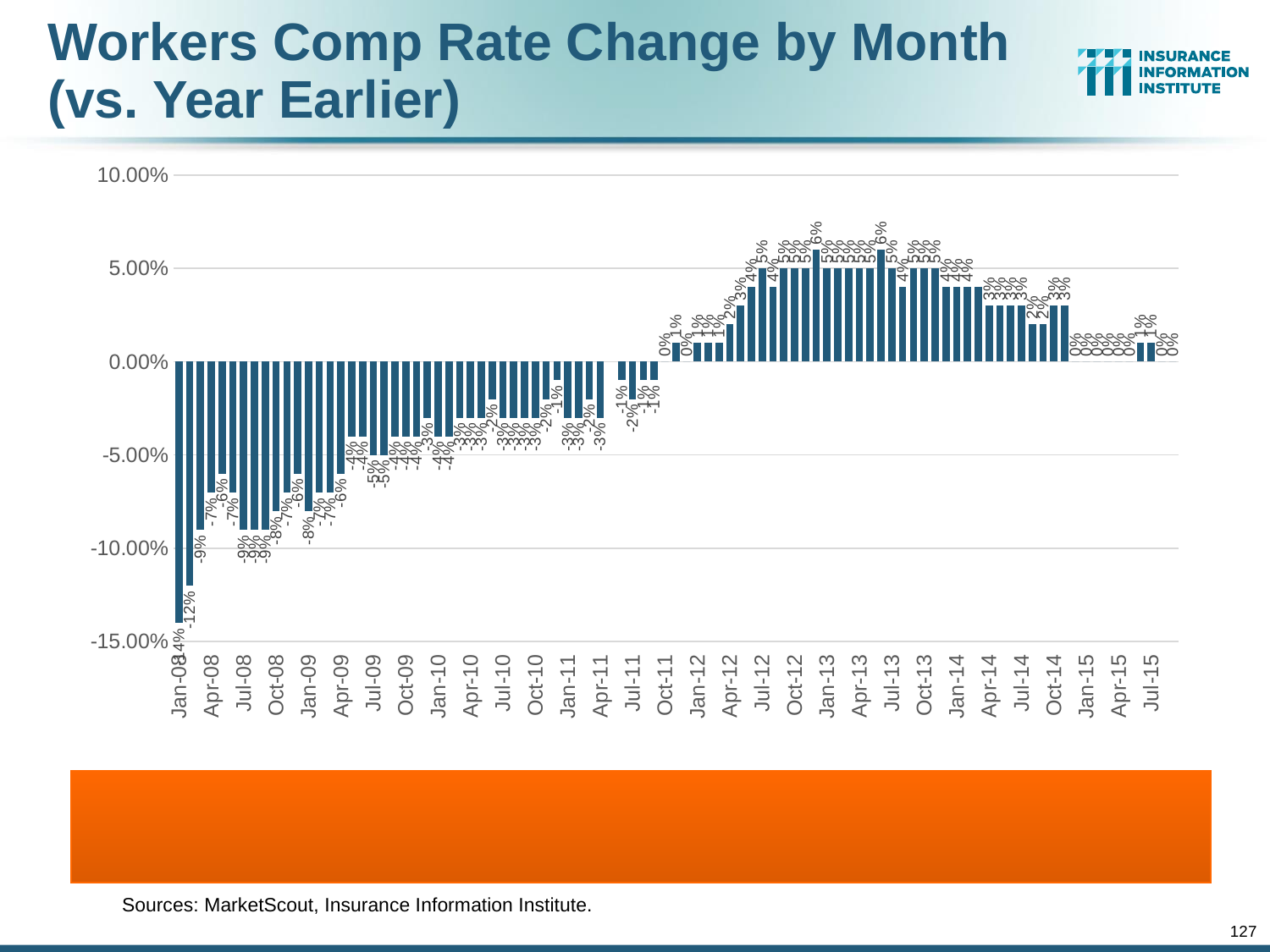
Is the value for Jul-08 greater or less than -5.00%? less Do the values generally rise or fall from Jan-08 to Jan-13? rise Is the value for Jan-13 greater or less than 0.00%? greater What is the workers comp rate change shown for Jan-08? -14% What sources are cited for the chart? MarketScout, Insurance Information Institute Is the value for Jan-11 greater or less than 0.00%? less What is the title of the chart? Workers Comp Rate Change by Month (vs. Year Earlier) Which month has the lowest workers comp rate change on the chart? Jan-08 Which is larger, the value for Jan-13 or the value for Jan-15? Jan-13 What kind of chart is shown on the slide? bar chart Which is larger, the value for Jan-08 or the value for Jan-13? Jan-13